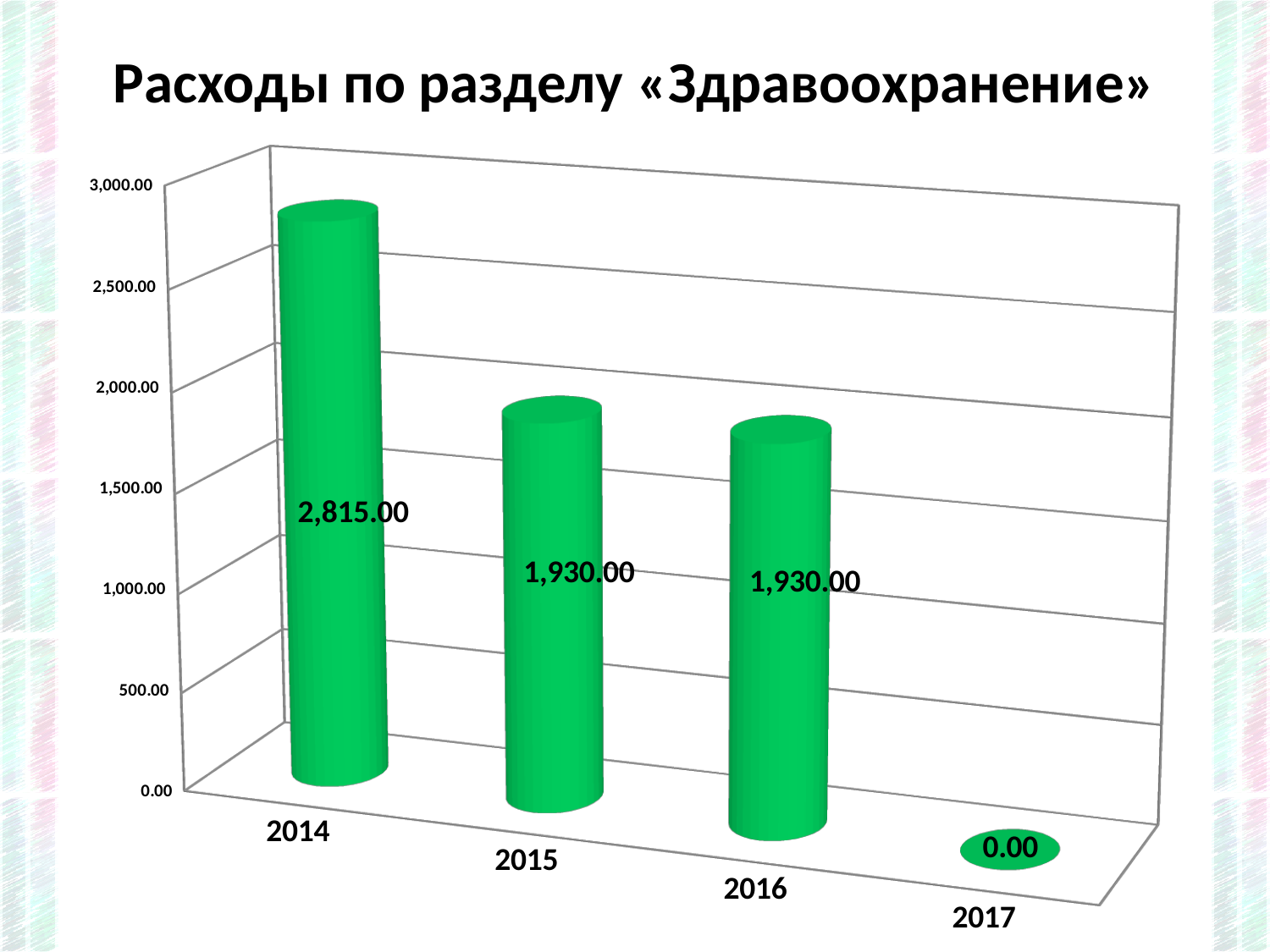
How many years are shown on the x axis? 4 What is the value for 2014? 2,815.00 Which year has the highest value? 2014 Which is larger, the value for 2014 or the value for 2016? 2014 What is the title of the chart? Расходы по разделу «Здравоохранение» What is the value for 2015? 1,930.00 Which year has the lowest value? 2017 What is the value for 2017? 0.00 What is the difference between the values for 2016 and 2017? 1,930.00 What is the difference between the values for 2014 and 2015? 885.00 What kind of chart is this? bar chart Is the value for 2015 greater or less than 2,000.00? less